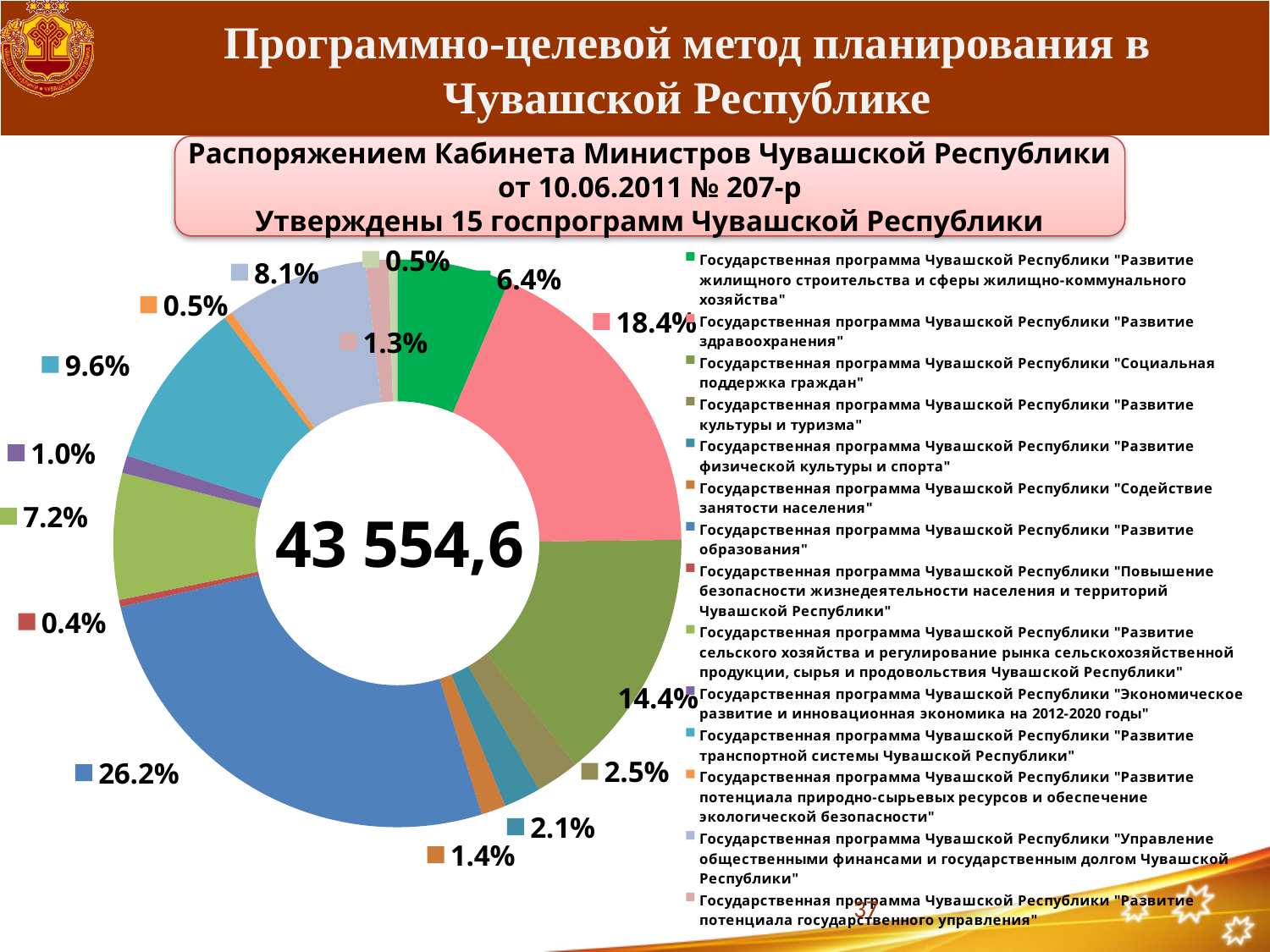
How many slices (data labels) does the pie chart have? 15 What kind of chart is shown on the slide? Pie (doughnut) chart What is the share of the programme "Развитие здравоохранения" (the pink slice)? 18.4% What is the share of the programme "Развитие образования" (the blue slice)? 26.2% What is the largest percentage shown on the pie chart? 26.2% According to the text box above the chart, how many state programmes of the Chuvash Republic were approved? 15 What is the share of the programme "Социальная поддержка граждан" (the olive-green slice)? 14.4% What is the smallest percentage shown on the pie chart? 0.4% How many slices on the chart are labelled 0.5%? 2 Which is larger: the 9.6% slice or the 8.1% slice? 9.6% What is the difference between the largest slice (26.2%) and the second largest slice (18.4%)? 7.8% What value is printed in the centre of the doughnut chart? 43 554,6